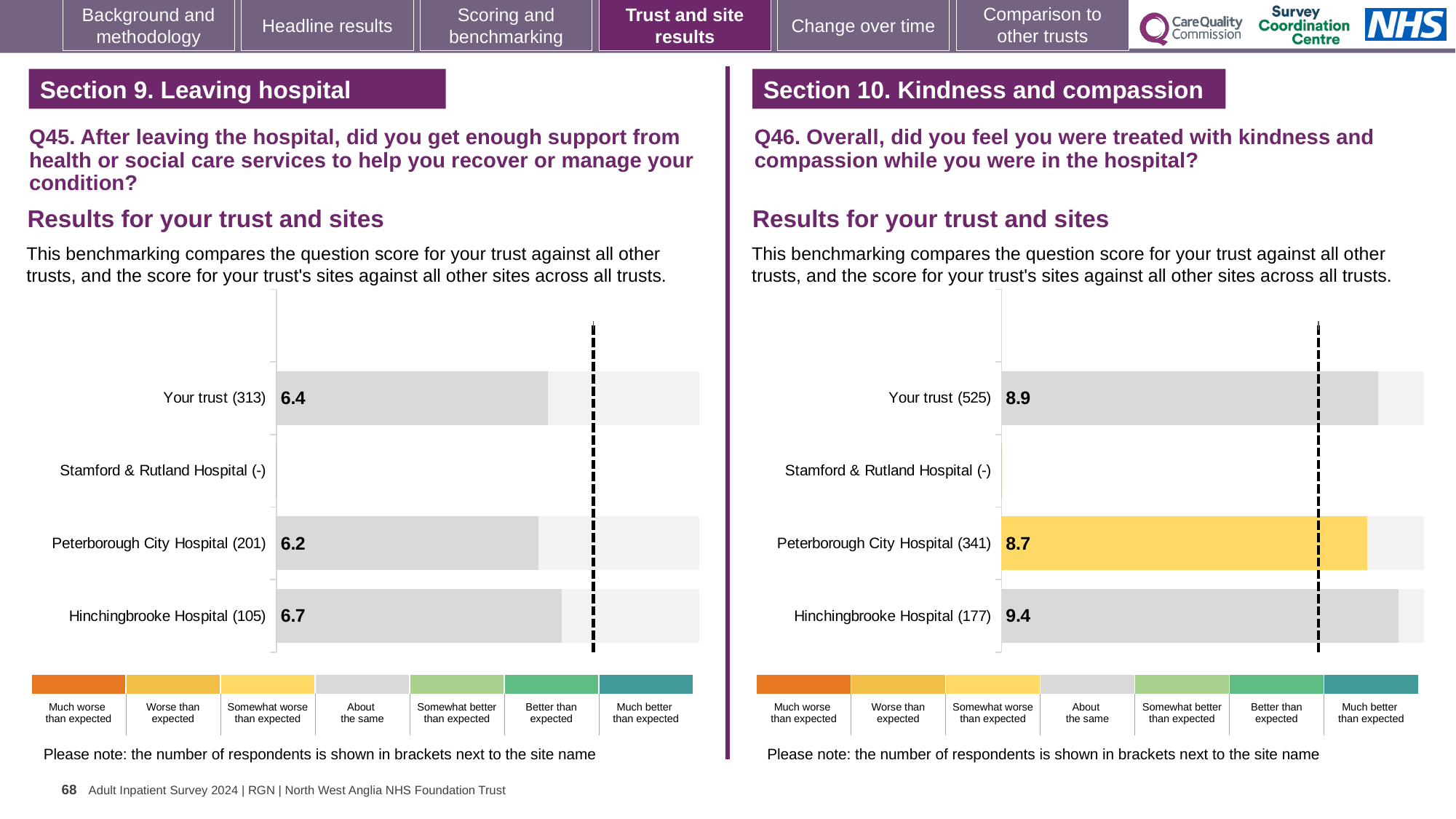
In the Q46 chart on the right, which benchmark category does the colour of the Peterborough City Hospital bar correspond to? Somewhat worse than expected In the Q46 chart on the right, which has the larger score, Your trust or Peterborough City Hospital? Your trust In the Q45 chart on the left, what is the difference between the scores for Hinchingbrooke Hospital and Peterborough City Hospital? 0.5 In the Q46 chart on the right, what is the score for Your trust? 8.9 In the Q46 chart on the right, which site has the highest score? Hinchingbrooke Hospital In the Q45 chart on the left, which site has the lowest score? Peterborough City Hospital How many respondents are shown in brackets for Your trust in the Q46 chart on the right? 525 In the Q45 chart on the left, what is the score for Hinchingbrooke Hospital? 6.7 In the Q46 chart on the right, what is the difference between the scores for Hinchingbrooke Hospital and Your trust? 0.5 What kind of chart is used in the Q45 chart on the left? Bar chart In the Q46 chart on the right, what is the score for Peterborough City Hospital? 8.7 In the Q45 chart on the left, what is the score for Your trust? 6.4